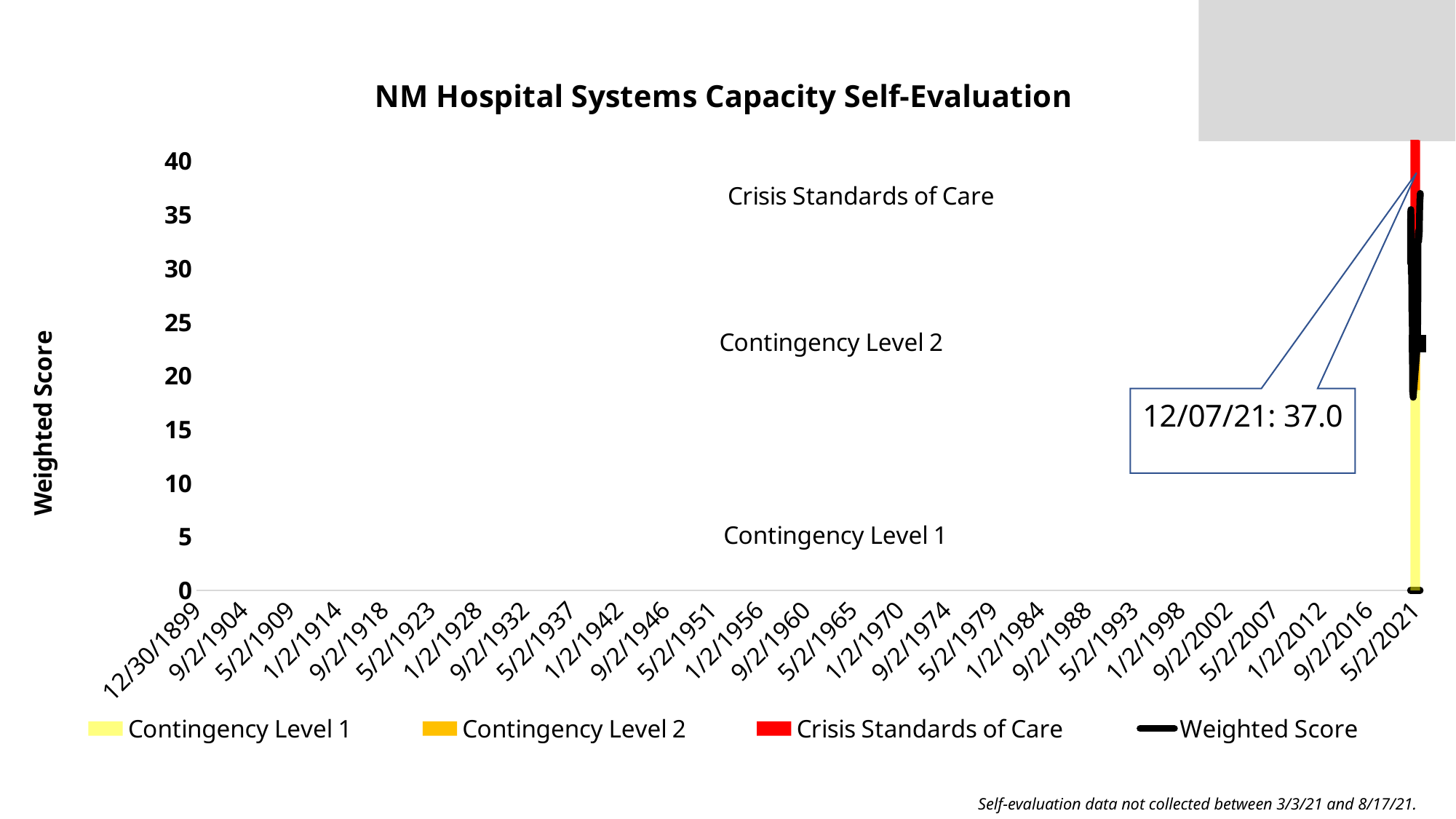
Is the Weighted Score for 12/07/21 greater or less than 40? less Is the Weighted Score for 12/07/21 greater or less than 35? greater How many series does the legend list? 4 What is the Weighted Score value shown in the callout for 12/07/21? 37.0 What is the title of the chart? NM Hospital Systems Capacity Self-Evaluation What is the label on the vertical axis? Weighted Score